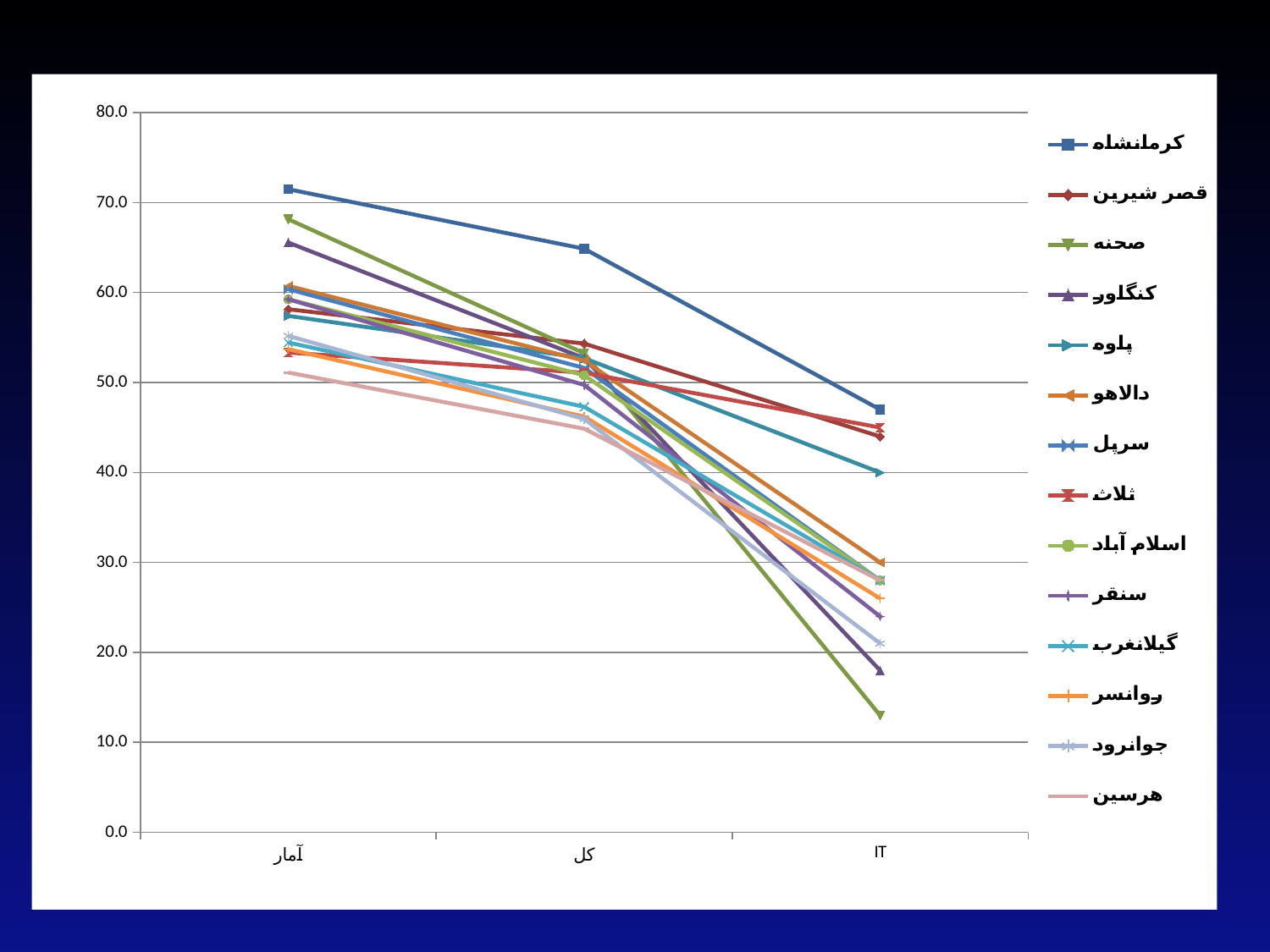
Which series has the highest value at آمار? کرمانشاه How many series does the legend list? 14 Is the value for کرمانشاه at آمار greater or less than 60? greater Do the values for کرمانشاه rise or fall from آمار to IT? fall What are the three labels on the x axis? آمار, کل, IT How many categories are shown on the x axis? 3 Which series has the lowest value at IT? صحنه Is the value for کرمانشاه at کل greater or less than 60? greater What kind of chart is shown on the slide? line chart Is the value for صحنه at IT greater or less than 20? less At IT, which is larger: the value for کرمانشاه or the value for صحنه? کرمانشاه